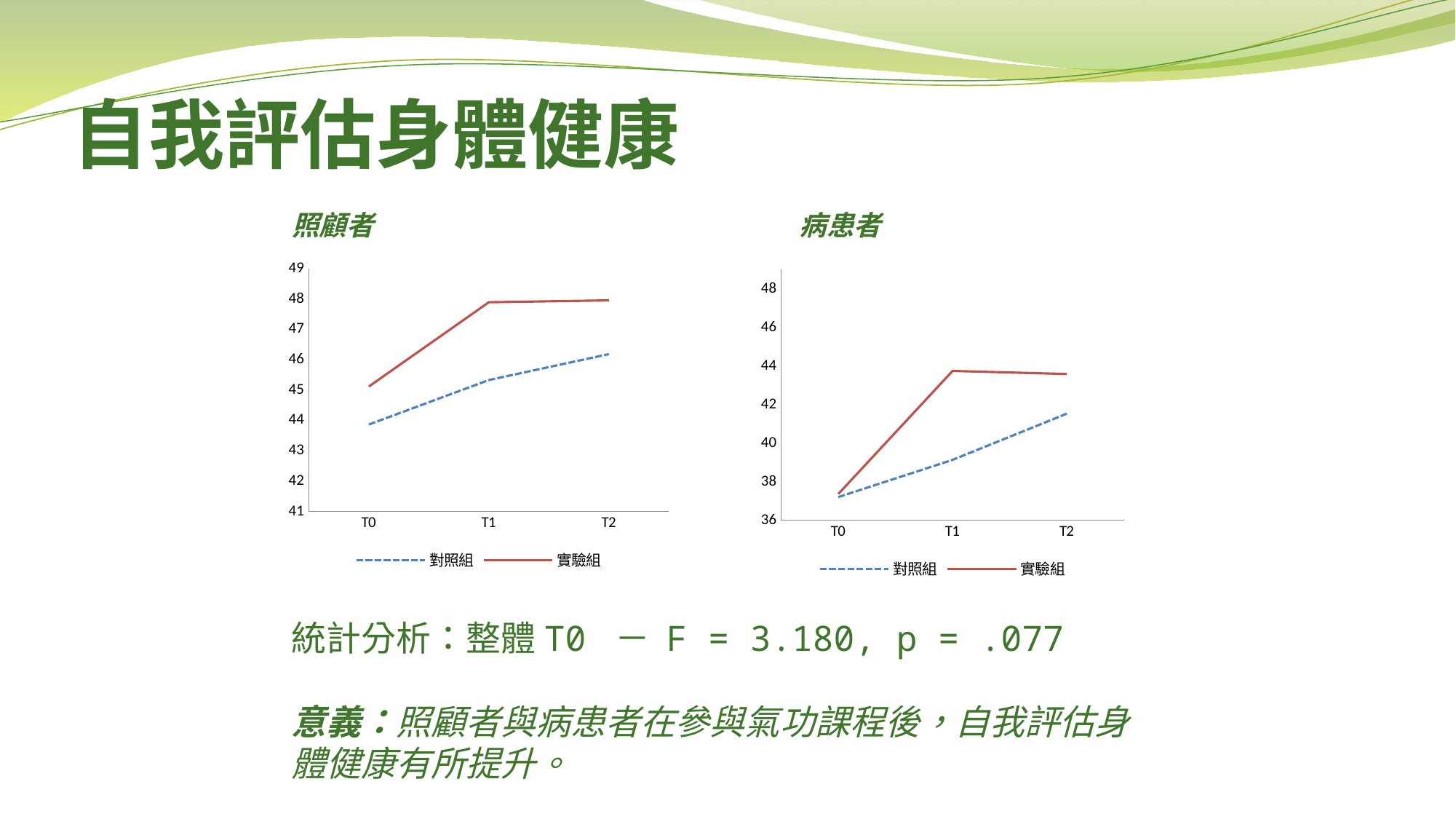
How many series does the legend of the 病患者 chart list? 2 In the 照顧者 chart, which series has the higher value at T2, 對照組 or 實驗組? 實驗組 How many time points are shown on the x axis of the 照顧者 chart? 3 In the 病患者 chart, which series has the higher value at T1, 對照組 or 實驗組? 實驗組 What is the title of the chart on the right side of the slide? 病患者 In the 病患者 chart, is the value for 對照組 at T2 greater or less than 42? less In the 照顧者 chart, is the value for 實驗組 at T1 greater or less than 47? greater What kind of chart is the 照顧者 chart? line chart In the 照顧者 chart, does the 對照組 line rise or fall from T0 to T2? rise Which series is drawn with a dashed line in the 病患者 chart? 對照組 In the 病患者 chart, is the value for 實驗組 at T1 greater or less than 42? greater